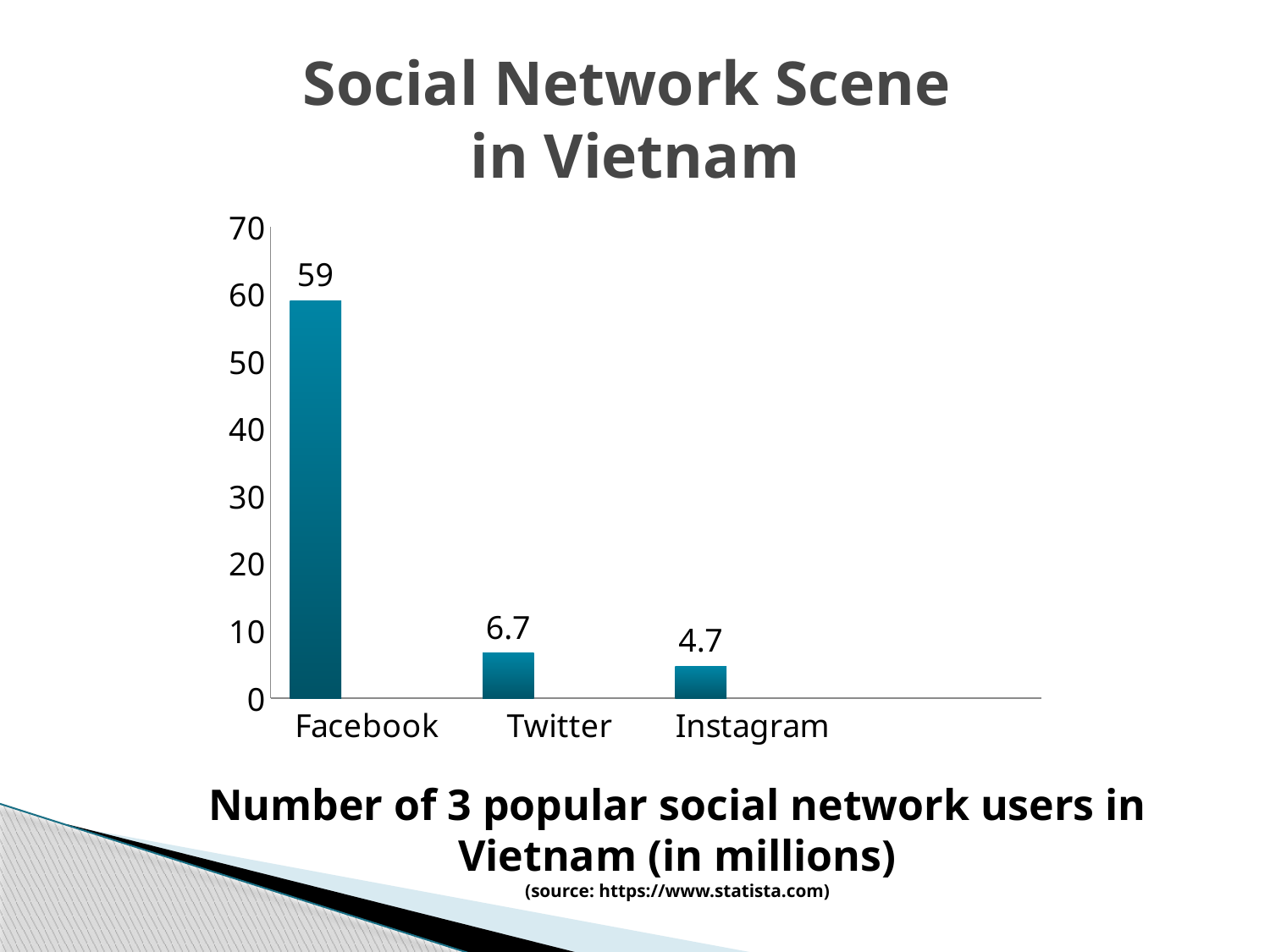
Is the value for Facebook greater or less than 50? greater Which social network has the lowest number of users? Instagram How many social networks are shown in the chart? 3 What is the title of the slide? Social Network Scene in Vietnam What is the difference between the values for Facebook and Twitter? 52.3 What is the value for Instagram? 4.7 What is the value for Twitter? 6.7 What is the difference between the values for Twitter and Instagram? 2 Which social network has the highest number of users? Facebook What is the value for Facebook? 59 Which is larger, the value for Twitter or the value for Instagram? Twitter What kind of chart is shown on the slide? bar chart